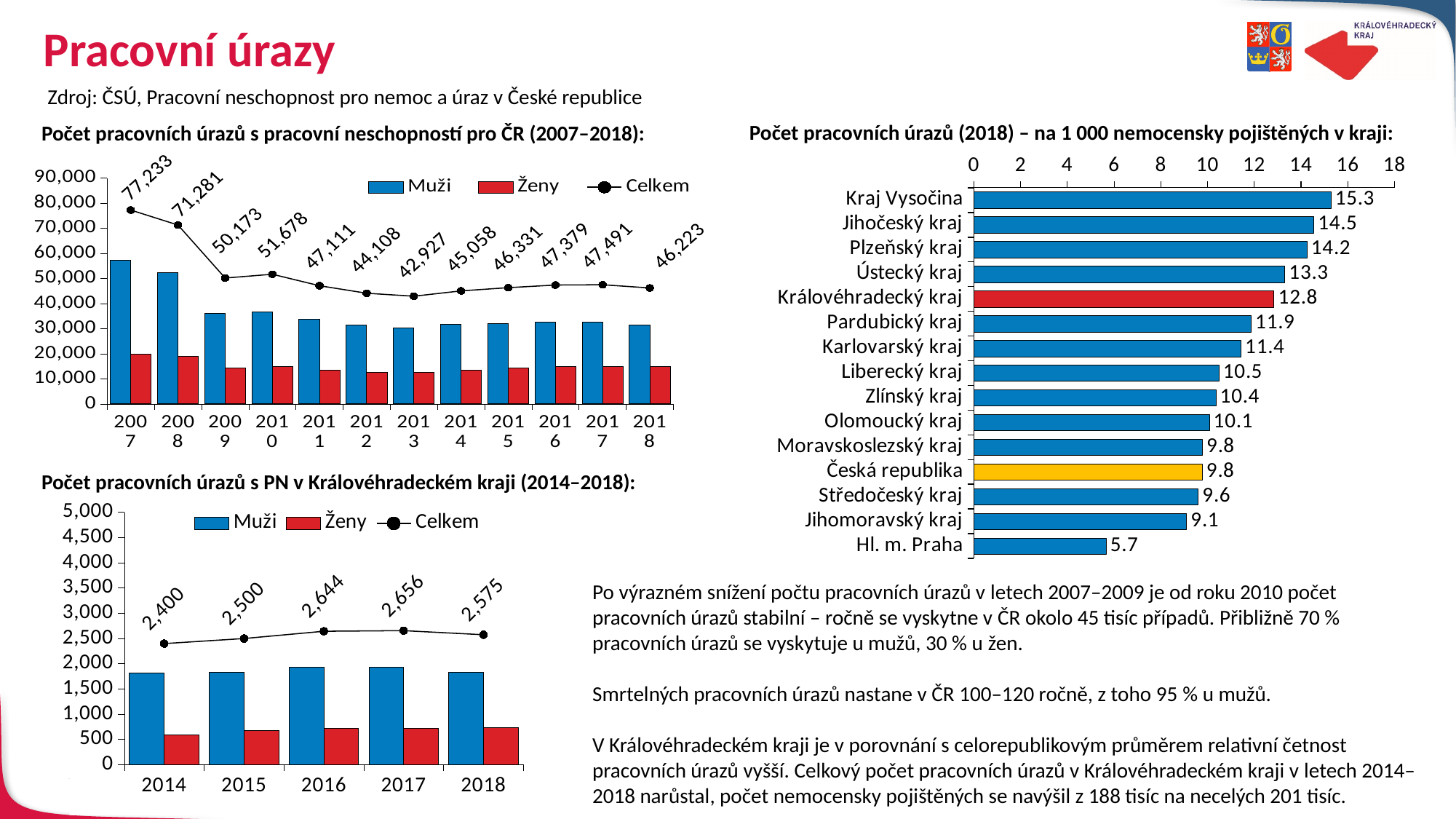
How many years are shown on the x axis of the chart 'Počet pracovních úrazů s pracovní neschopností pro ČR (2007–2018)'? 12 What kind of chart is 'Počet pracovních úrazů (2018) – na 1 000 nemocensky pojištěných v kraji'? bar chart In the chart 'Počet pracovních úrazů s PN v Královéhradeckém kraji (2014–2018)', what is the Celkem value for 2016? 2,644 In the chart 'Počet pracovních úrazů s pracovní neschopností pro ČR (2007–2018)', which year has the lowest Celkem value? 2013 How many series does the legend list in the chart 'Počet pracovních úrazů s PN v Královéhradeckém kraji (2014–2018)'? 3 In the chart 'Počet pracovních úrazů s pracovní neschopností pro ČR (2007–2018)', is the Muži value for 2007 greater or less than 50,000? greater In the chart 'Počet pracovních úrazů s pracovní neschopností pro ČR (2007–2018)', what is the difference between the Celkem values for 2007 and 2008? 5,952 In the chart 'Počet pracovních úrazů (2018) – na 1 000 nemocensky pojištěných v kraji', what is the value for Královéhradecký kraj? 12.8 In the chart 'Počet pracovních úrazů s PN v Královéhradeckém kraji (2014–2018)', which year has the highest Celkem value? 2017 In the chart 'Počet pracovních úrazů s pracovní neschopností pro ČR (2007–2018)', what is the Celkem value for 2007? 77,233 In the chart 'Počet pracovních úrazů (2018) – na 1 000 nemocensky pojištěných v kraji', which category has the lowest value? Hl. m. Praha In the chart 'Počet pracovních úrazů s PN v Královéhradeckém kraji (2014–2018)', what is the difference between the Celkem values for 2017 and 2014? 256